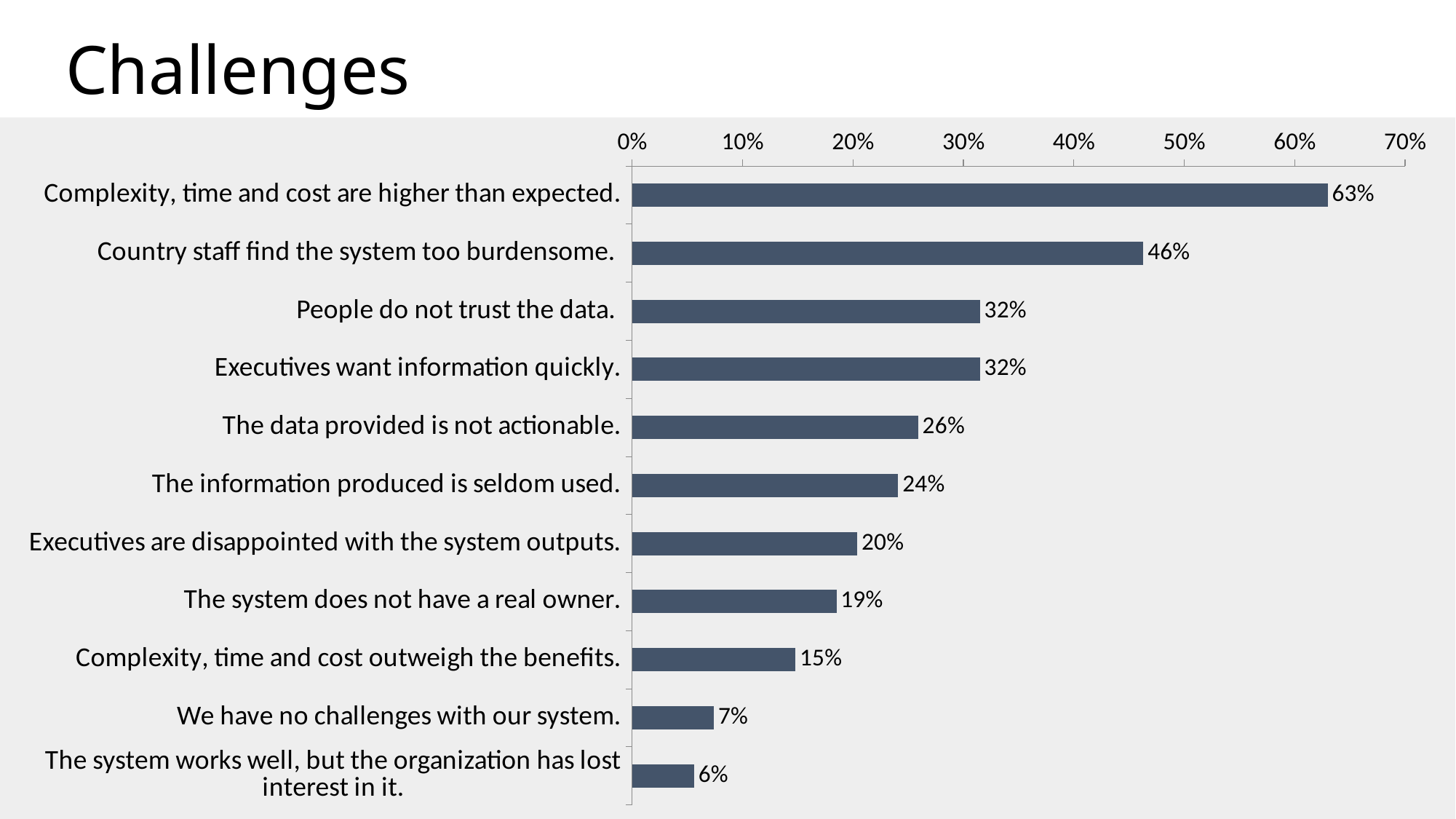
Which is larger: "Executives are disappointed with the system outputs." or "Complexity, time and cost outweigh the benefits."? Executives are disappointed with the system outputs. What is the difference between "Complexity, time and cost are higher than expected." and "Country staff find the system too burdensome."? 17% What kind of chart is shown on the slide? Bar chart Which category has the lowest value? The system works well, but the organization has lost interest in it. What percentage is shown for "Country staff find the system too burdensome."? 46% Which challenge has the highest percentage? Complexity, time and cost are higher than expected. What is the title of the slide? Challenges What is the value for "The system does not have a real owner."? 19% Is the value for "People do not trust the data." greater or less than 30%? greater What percentage is shown for "We have no challenges with our system."? 7% What is the difference between "The data provided is not actionable." and "The information produced is seldom used."? 2% How many categories are shown in the chart? 11